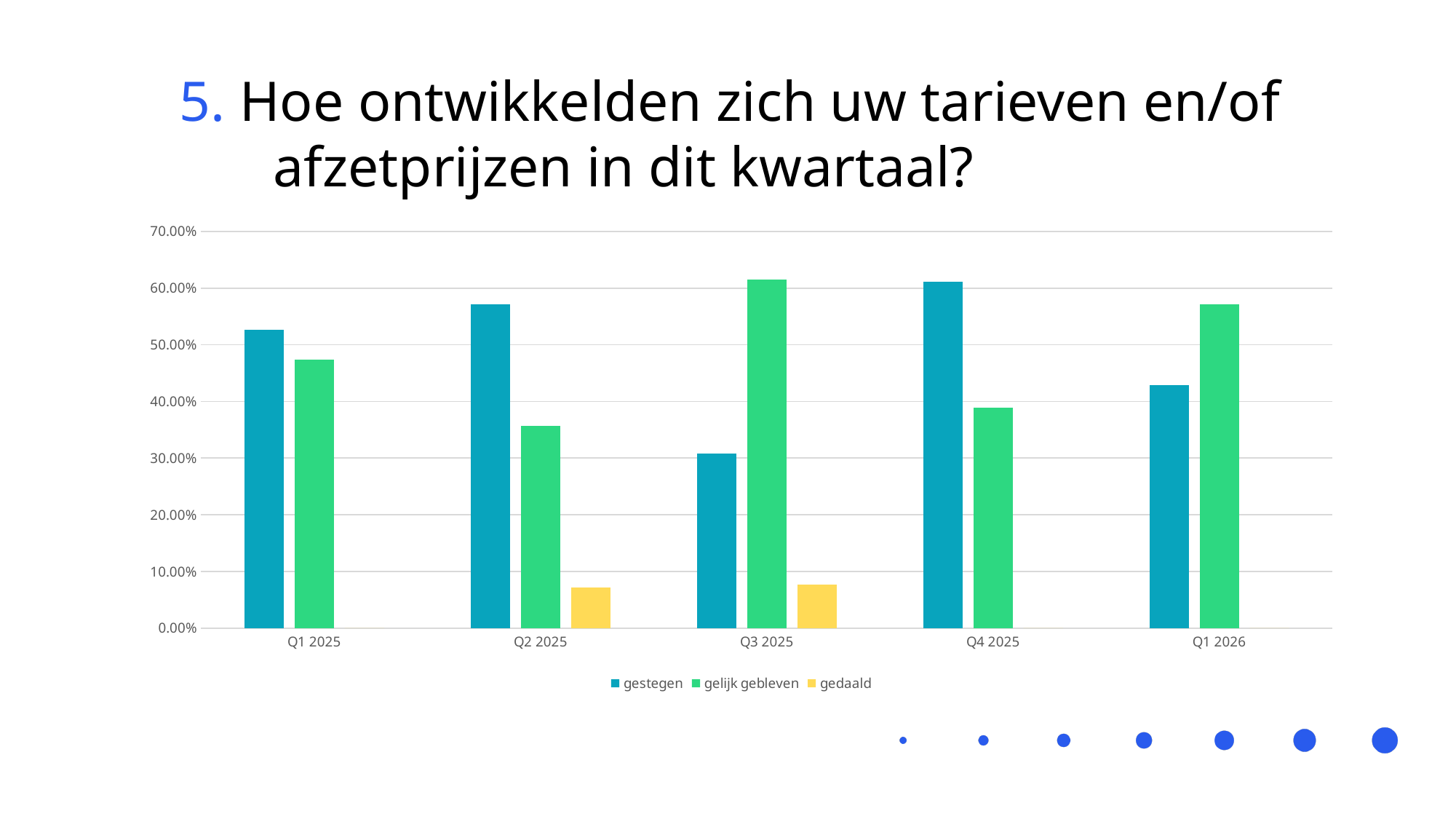
How many series does the chart's legend list? 3 In which quarter is the 'gestegen' bar the highest? Q4 2025 Which series in the legend is shown in yellow? gedaald For Q1 2025, which is larger: 'gestegen' or 'gelijk gebleven'? gestegen Is the 'gestegen' value for Q3 2025 greater or less than 40.00%? less For Q3 2025, which is larger: 'gestegen' or 'gelijk gebleven'? gelijk gebleven In which quarter is the 'gelijk gebleven' bar the highest? Q3 2025 What kind of chart is shown on the slide? bar chart In which quarter is the 'gestegen' bar the lowest? Q3 2025 Is the 'gedaald' value for Q2 2025 greater or less than 10.00%? less Is the 'gestegen' value for Q1 2025 greater or less than 50.00%? greater How many quarters are shown on the x axis of the chart? 5